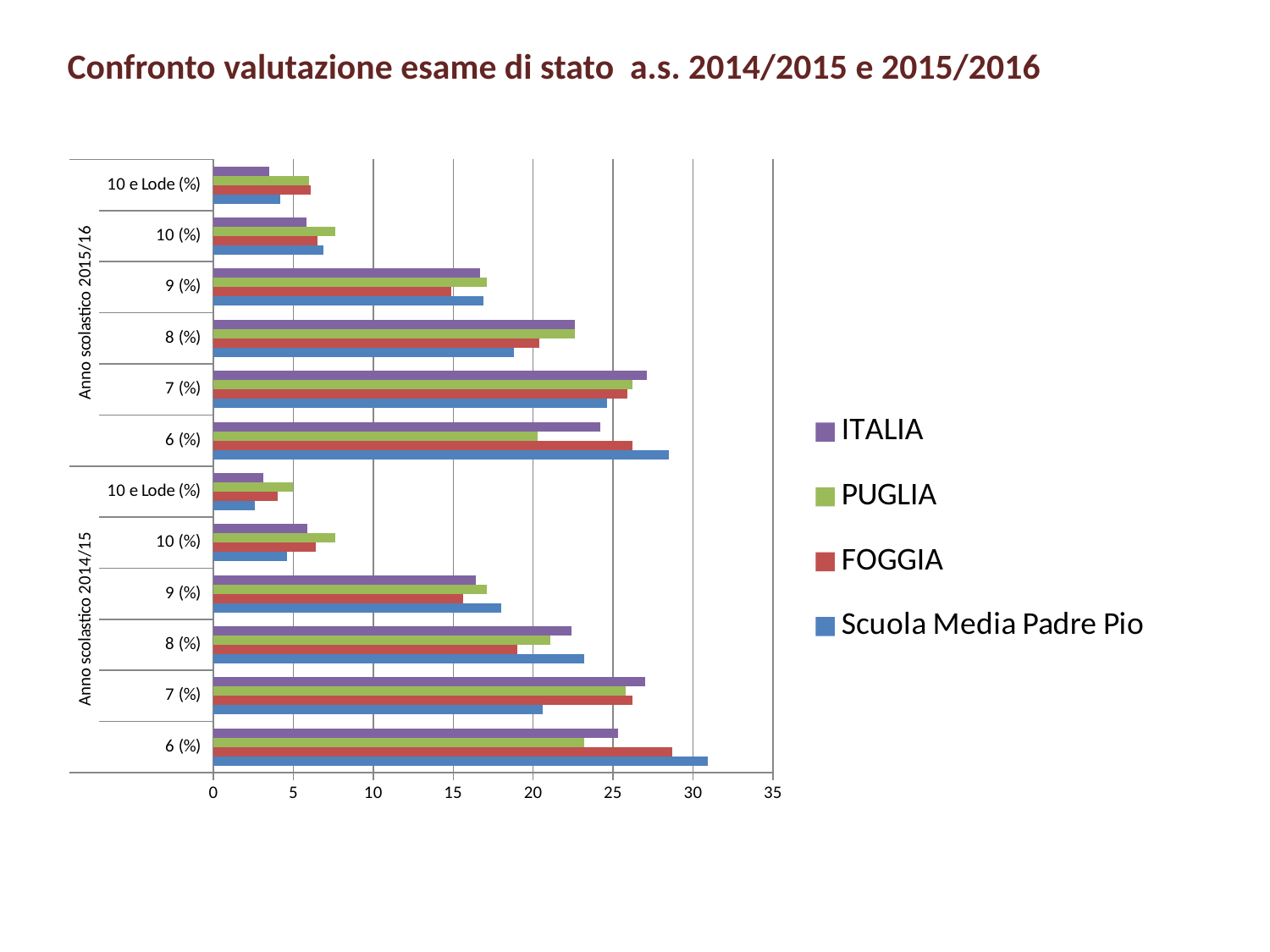
For 7 (%) in Anno scolastico 2014/15, which is larger: ITALIA or Scuola Media Padre Pio? ITALIA For 10 e Lode (%) in Anno scolastico 2014/15, which series has the lowest value? Scuola Media Padre Pio Is the value for PUGLIA at 8 (%) in Anno scolastico 2015/16 greater or less than 20? greater How many grade categories are plotted in total across both school years? 12 How many series does the legend list? 4 What kind of chart is shown on the slide? Bar chart Which series are listed in the legend? ITALIA, PUGLIA, FOGGIA, Scuola Media Padre Pio Is the value for Scuola Media Padre Pio at 6 (%) in Anno scolastico 2014/15 greater or less than 30? greater For 6 (%) in Anno scolastico 2015/16, which is larger: PUGLIA or FOGGIA? FOGGIA What is the title of the slide? Confronto valutazione esame di stato a.s. 2014/2015 e 2015/2016 For 6 (%) in Anno scolastico 2014/15, which series has the highest value? Scuola Media Padre Pio Is the value for ITALIA at 10 e Lode (%) in Anno scolastico 2015/16 greater or less than 5? less